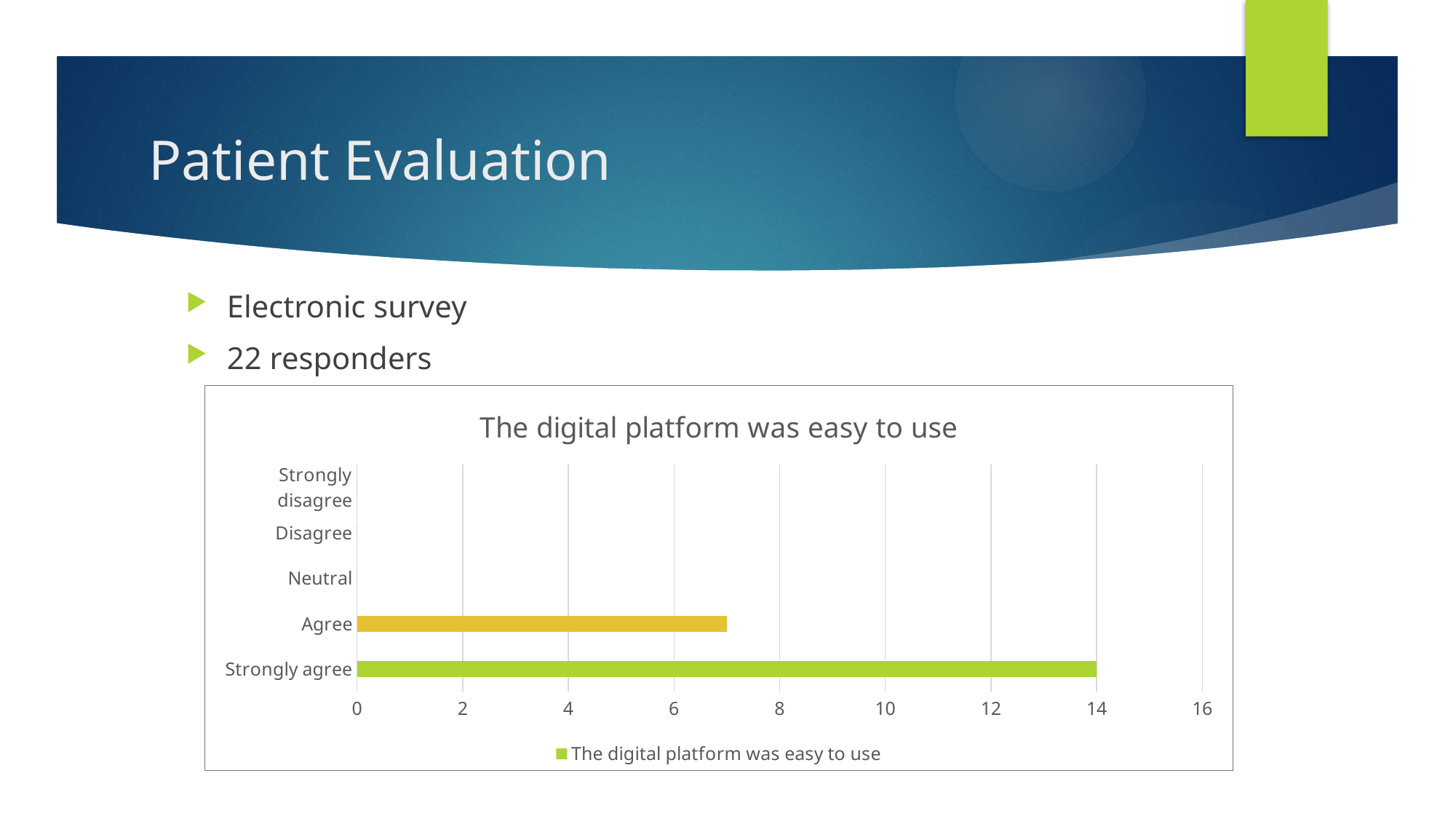
Is the value for Strongly agree greater or less than 10? greater How many categories are shown on the chart's vertical axis? 5 Is the value for Agree greater or less than 6? greater What is the value for Strongly agree? 14 What is the title of the chart? The digital platform was easy to use What is the highest value shown on the horizontal axis? 16 Which category has the highest value? Strongly agree What kind of chart is shown on the slide? Bar chart How many series does the legend list? 1 Is the value for Agree greater or less than 8? less Which is larger, the value for Strongly agree or the value for Agree? Strongly agree